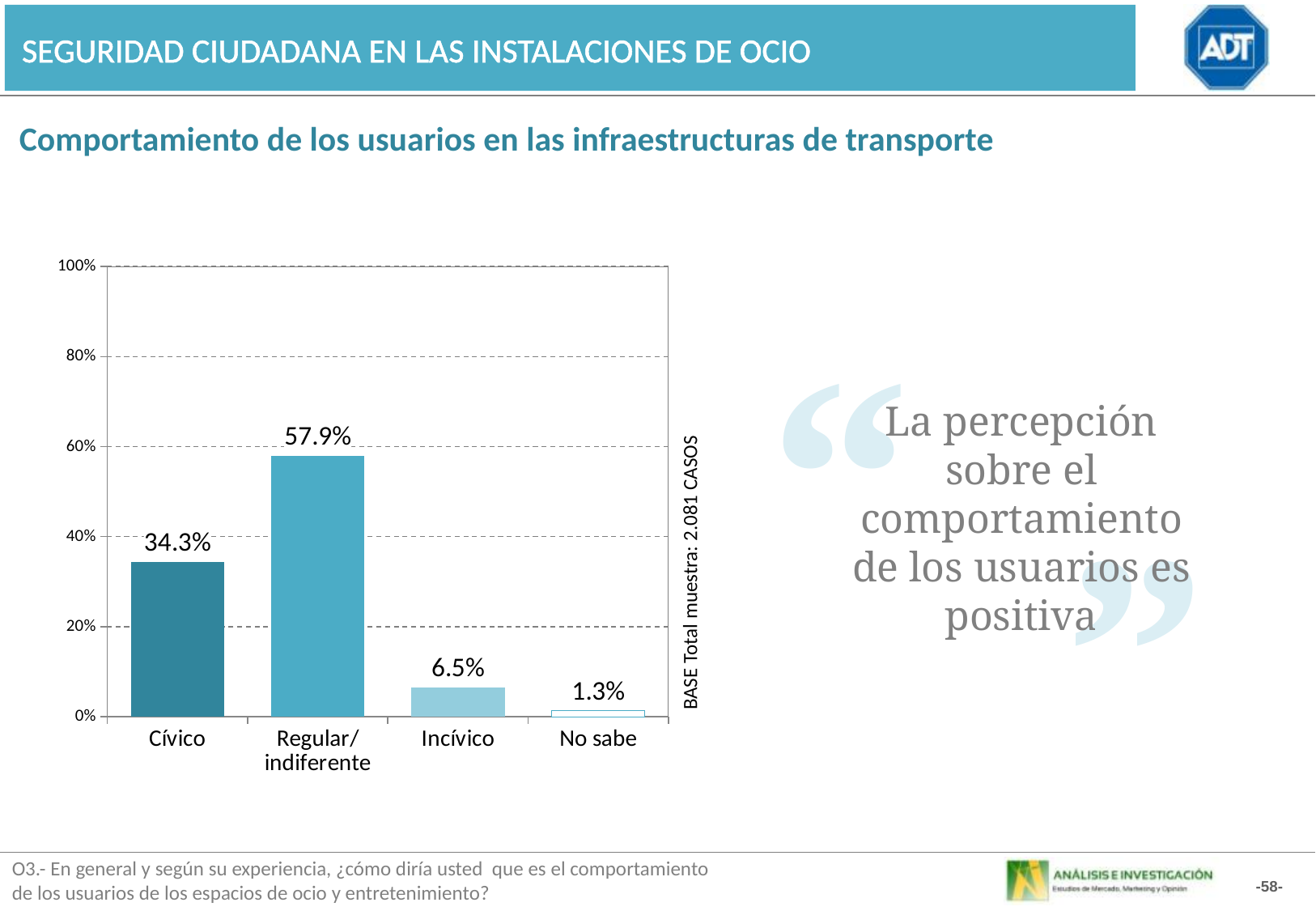
What is the value for No sabe? 1.3% Is the value for Regular/indiferente greater or less than 40%? greater Which category has the lowest value? No sabe Which category has the highest value? Regular/indiferente What is the value for Cívico? 34.3% How many categories are shown on the x axis? 4 What kind of chart is shown on the slide? bar chart What is the value for Incívico? 6.5% What is the difference between the values for Regular/indiferente and Cívico? 23.6% What is the base (total sample) stated next to the chart? 2.081 CASOS Which is larger, the value for Cívico or the value for Incívico? Cívico What is the value for Regular/indiferente? 57.9%